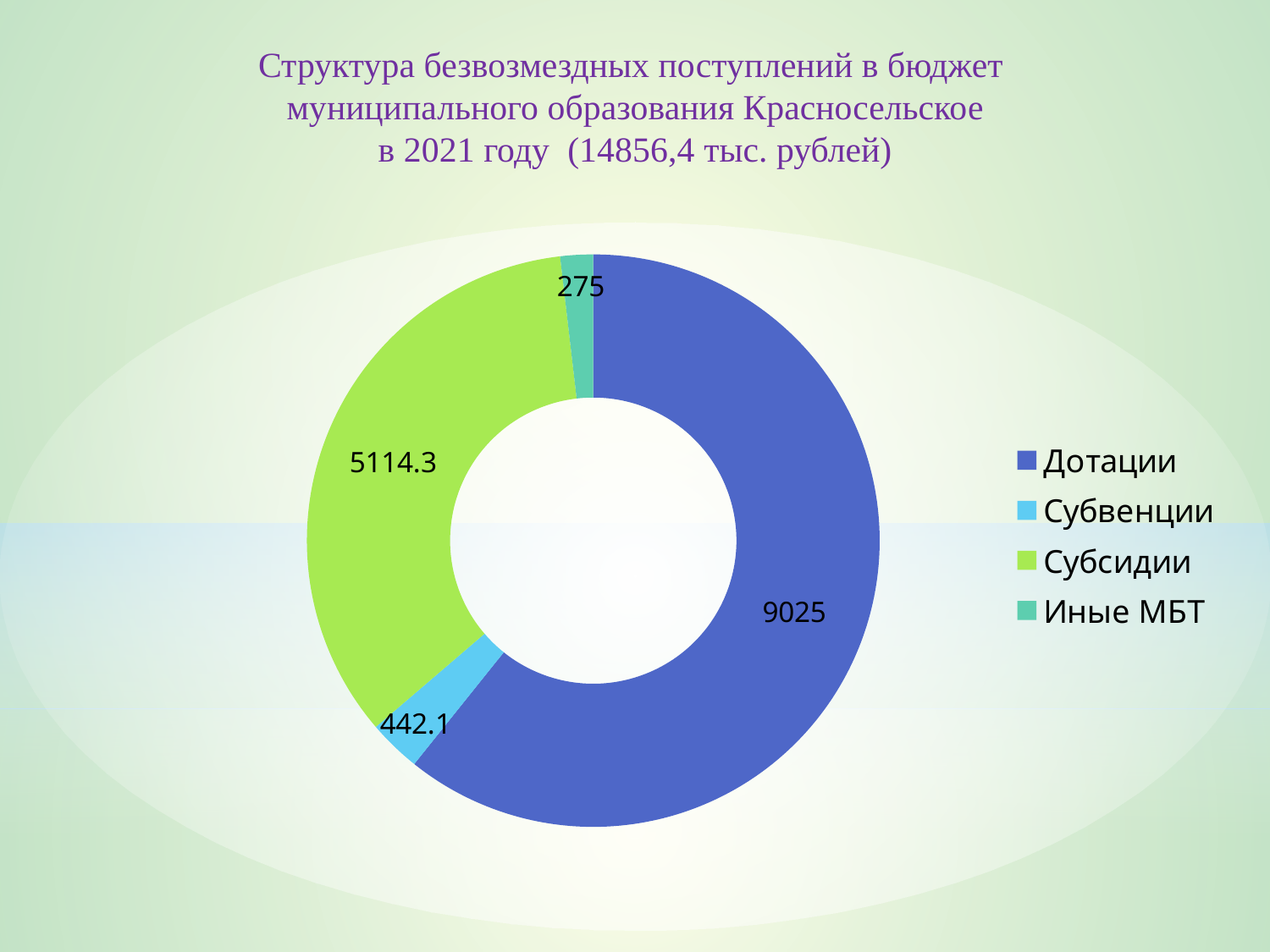
Which is larger, Субсидии or Субвенции? Субсидии Which category has the largest value? Дотации What is the difference between the values for Дотации and Субсидии? 3910.7 How many categories are shown in the chart? 4 What is the total of all four values shown in the chart? 14856.4 What is the value for Иные МБТ? 275 What kind of chart is shown on the slide? Doughnut chart Which category has the smallest value? Иные МБТ What is the value for Субсидии? 5114.3 What is the value for Субвенции? 442.1 What is the value for Дотации? 9025 What is the difference between the values for Субвенции and Иные МБТ? 167.1